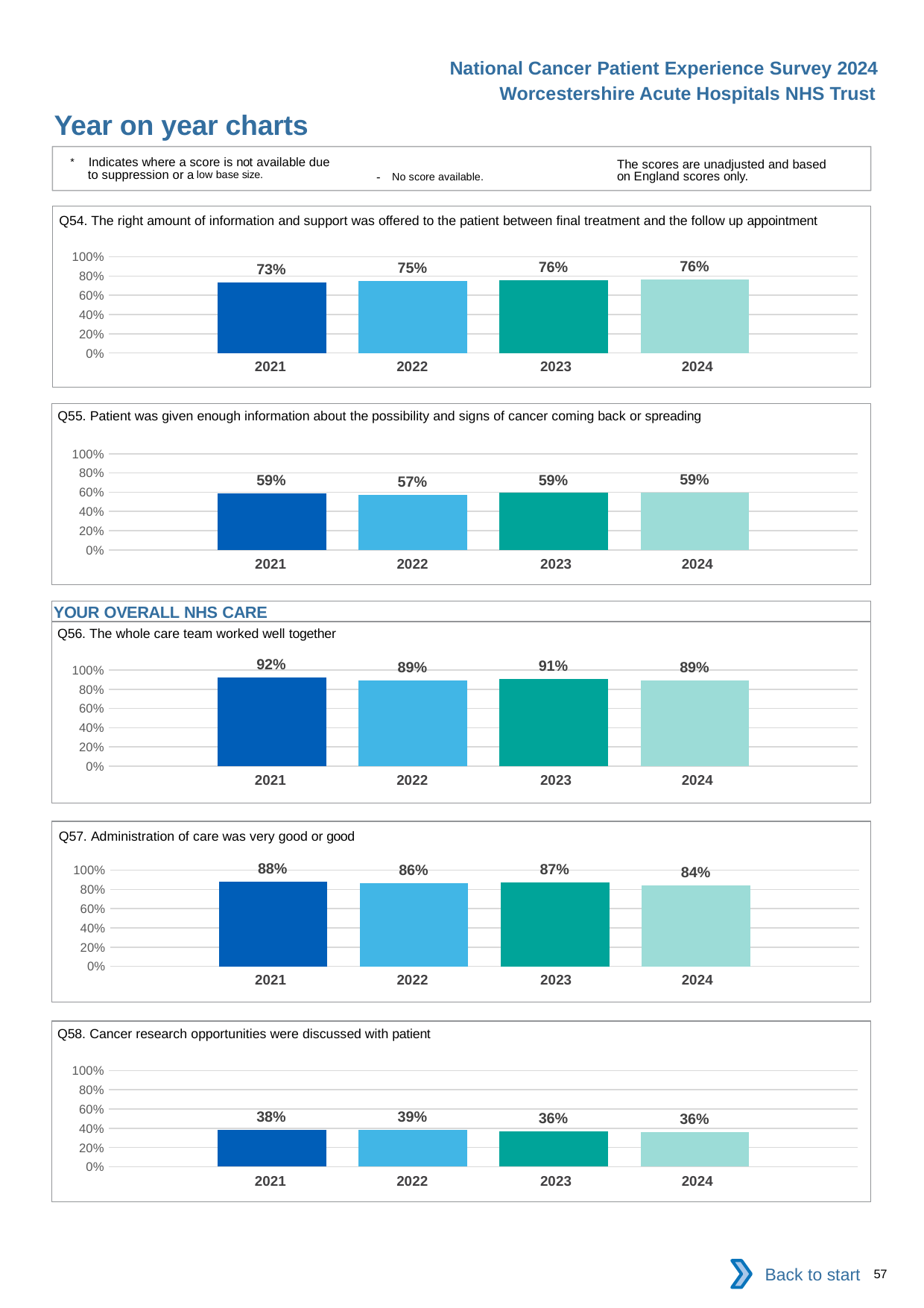
In the Q54 chart, what is the value for 2021? 73% What is the section heading shown above the Q56 chart? YOUR OVERALL NHS CARE In the Q58 chart, is the value for 2021 greater or less than 60%? less In the Q57 chart, which is larger, the value for 2022 or the value for 2023? 2023 In the Q54 chart, do the values rise or fall from 2021 to 2023? rise How many years are shown in the Q54 chart? 4 In the Q56 chart, what is the value for 2024? 89% In the Q55 chart, which year has the lowest value? 2022 In the Q57 chart, what is the difference between the 2021 and 2024 values? 4% What kind of chart is the Q56 chart? bar chart In the Q58 chart, what is the value for 2022? 39% In the Q56 chart, which year has the highest value? 2021